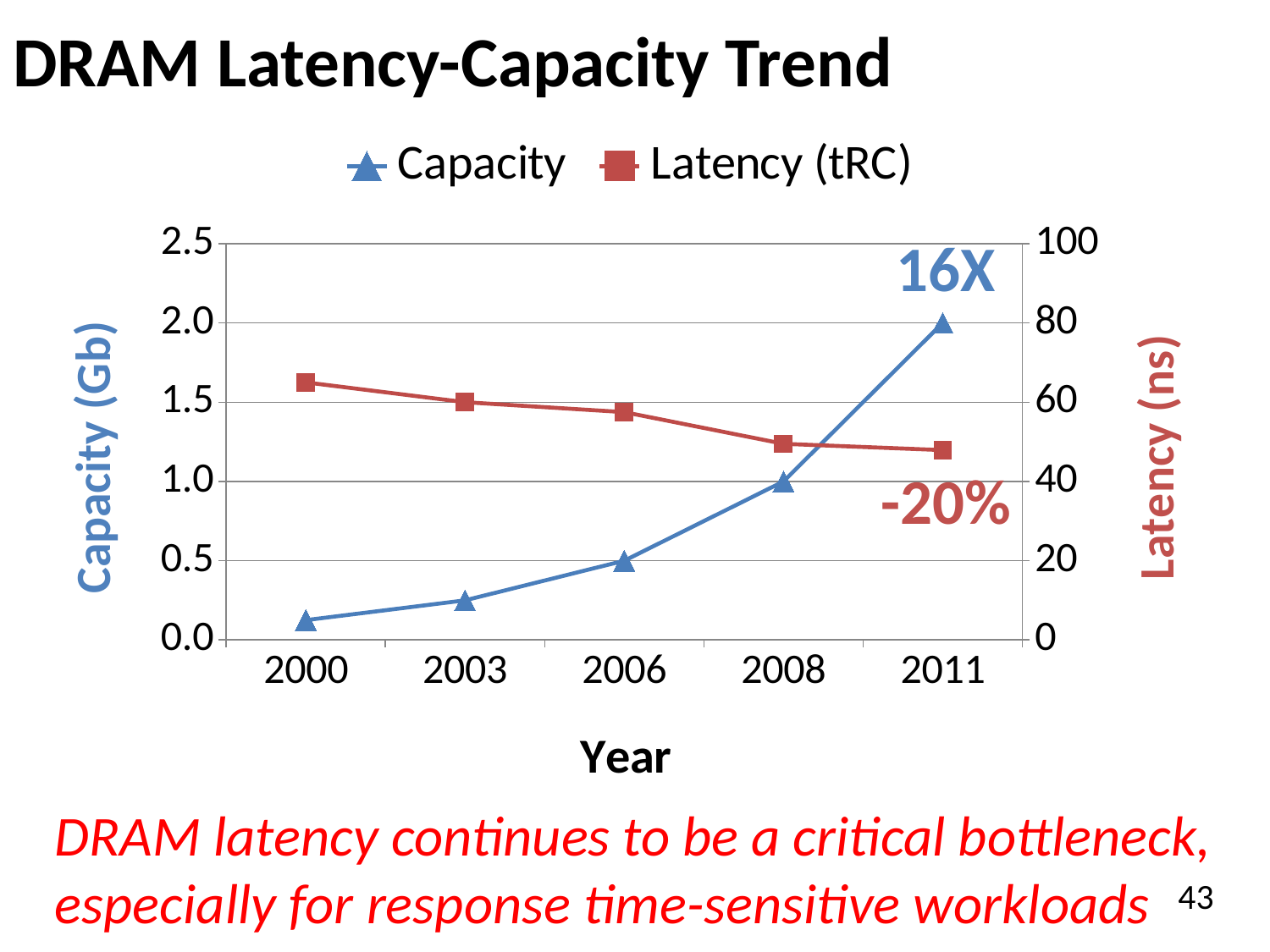
Does the Latency (tRC) series rise or fall from 2000 to 2011? fall How many series does the legend list? 2 In which year is Latency (tRC) highest? 2000 Which year has the larger Capacity, 2008 or 2011? 2011 Does the Capacity series rise or fall from 2000 to 2011? rise What kind of chart is shown on the slide? line chart How many years are plotted along the x axis? 5 Is the Latency (tRC) value for 2011 greater or less than 60? less What is the Capacity value in 2011? 2.0 In which year is Capacity highest? 2011 What annotation is printed next to the Capacity line at 2011? 16X Is the Latency (tRC) value for 2000 greater or less than 60? greater